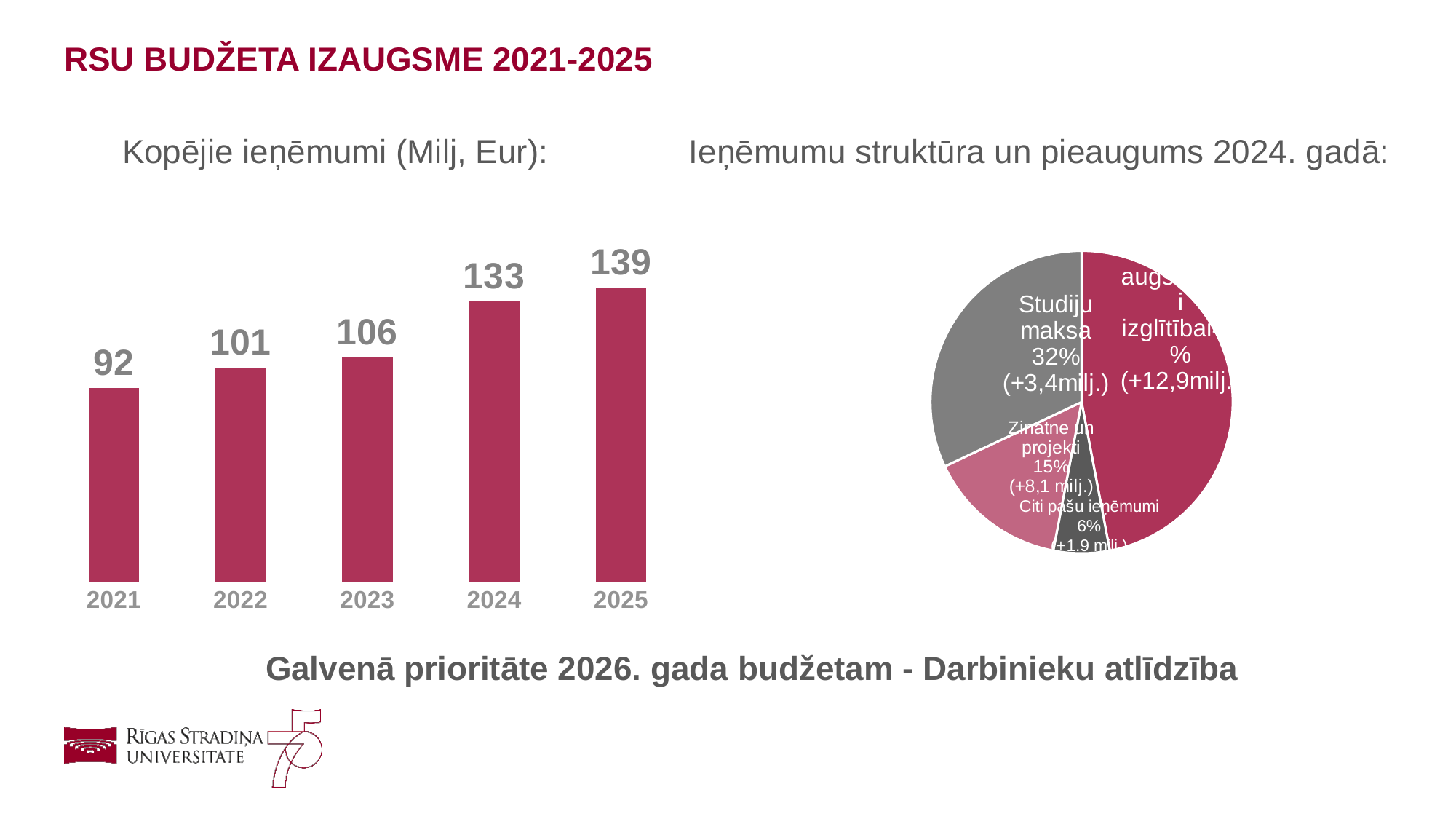
In the pie chart 'Ieņēmumu struktūra un pieaugums 2024. gadā', what share does 'Citi pašu ieņēmumi' have? 6% In the bar chart 'Kopējie ieņēmumi (Milj, Eur)', what is the difference between the values for 2024 and 2023? 27 How many years are shown in the bar chart 'Kopējie ieņēmumi (Milj, Eur)'? 5 In the bar chart 'Kopējie ieņēmumi (Milj, Eur)', which is larger, the value for 2022 or the value for 2023? 2023 What kind of chart is 'Kopējie ieņēmumi (Milj, Eur)'? bar chart In the bar chart 'Kopējie ieņēmumi (Milj, Eur)', which year has the highest value? 2025 In the bar chart 'Kopējie ieņēmumi (Milj, Eur)', do the values rise or fall from 2021 to 2025? rise In the bar chart 'Kopējie ieņēmumi (Milj, Eur)', what is the value for 2021? 92 In the pie chart 'Ieņēmumu struktūra un pieaugums 2024. gadā', what share does 'Studiju maksa' have? 32% In the bar chart 'Kopējie ieņēmumi (Milj, Eur)', which year has the lowest value? 2021 In the bar chart 'Kopējie ieņēmumi (Milj, Eur)', what is the value for 2024? 133 In the bar chart 'Kopējie ieņēmumi (Milj, Eur)', what is the difference between the values for 2025 and 2021? 47